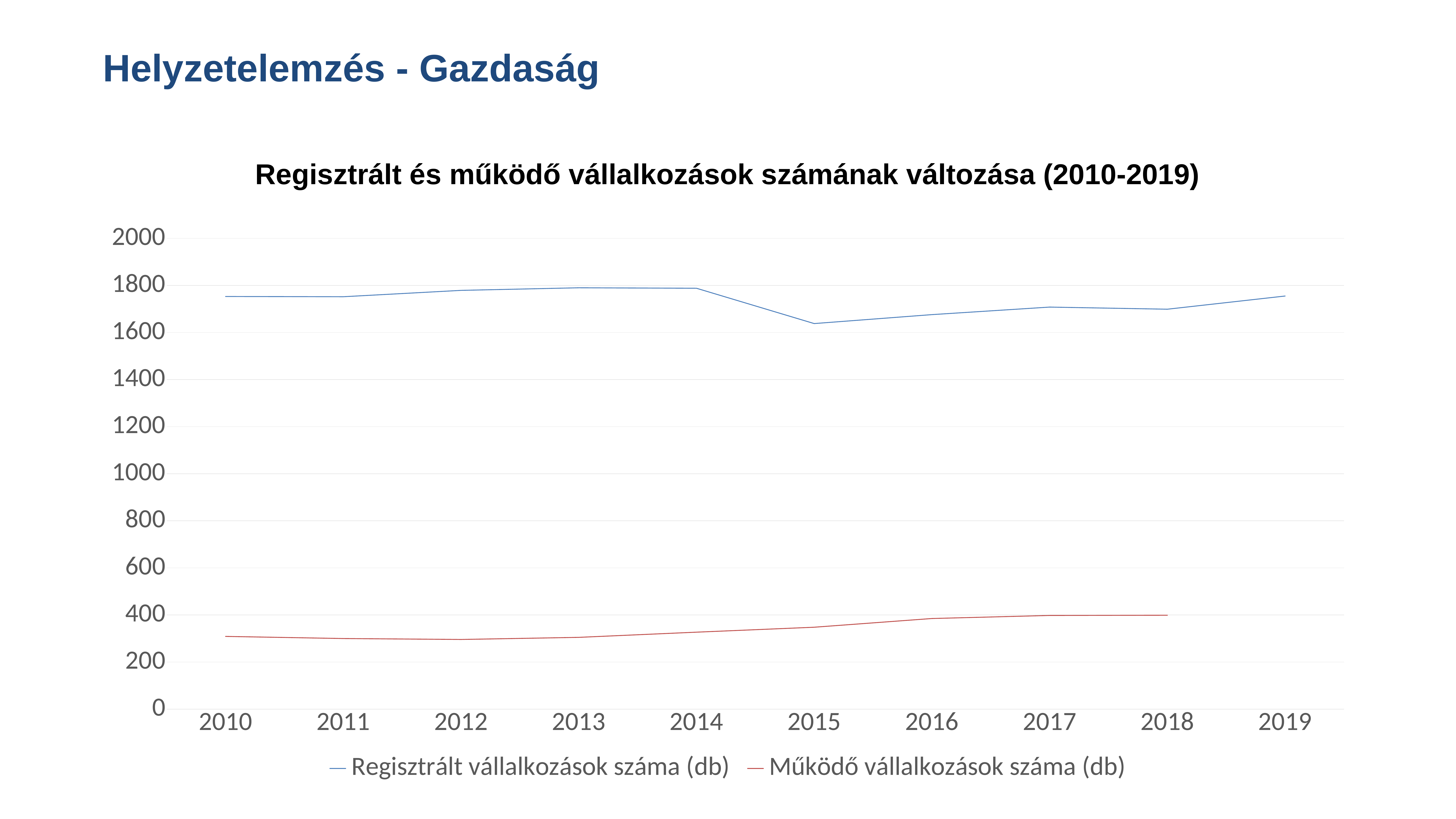
Is the value for Működő vállalkozások száma (db) in 2010 greater or less than 200? greater What is the title of the chart? Regisztrált és működő vállalkozások számának változása (2010-2019) Is the value for Regisztrált vállalkozások száma (db) in 2015 greater or less than 1600? greater Does the value for Működő vállalkozások száma (db) rise or fall from 2012 to 2018? rise Which is larger in 2015: Regisztrált vállalkozások száma (db) or Működő vállalkozások száma (db)? Regisztrált vállalkozások száma (db) How many years are shown on the x axis? 10 How many series does the legend list? 2 Is the value for Működő vállalkozások száma (db) in 2018 greater or less than 600? less What kind of chart is shown on the slide? line chart In which year is the value for Regisztrált vállalkozások száma (db) lowest? 2015 Which series is drawn in red? Működő vállalkozások száma (db)